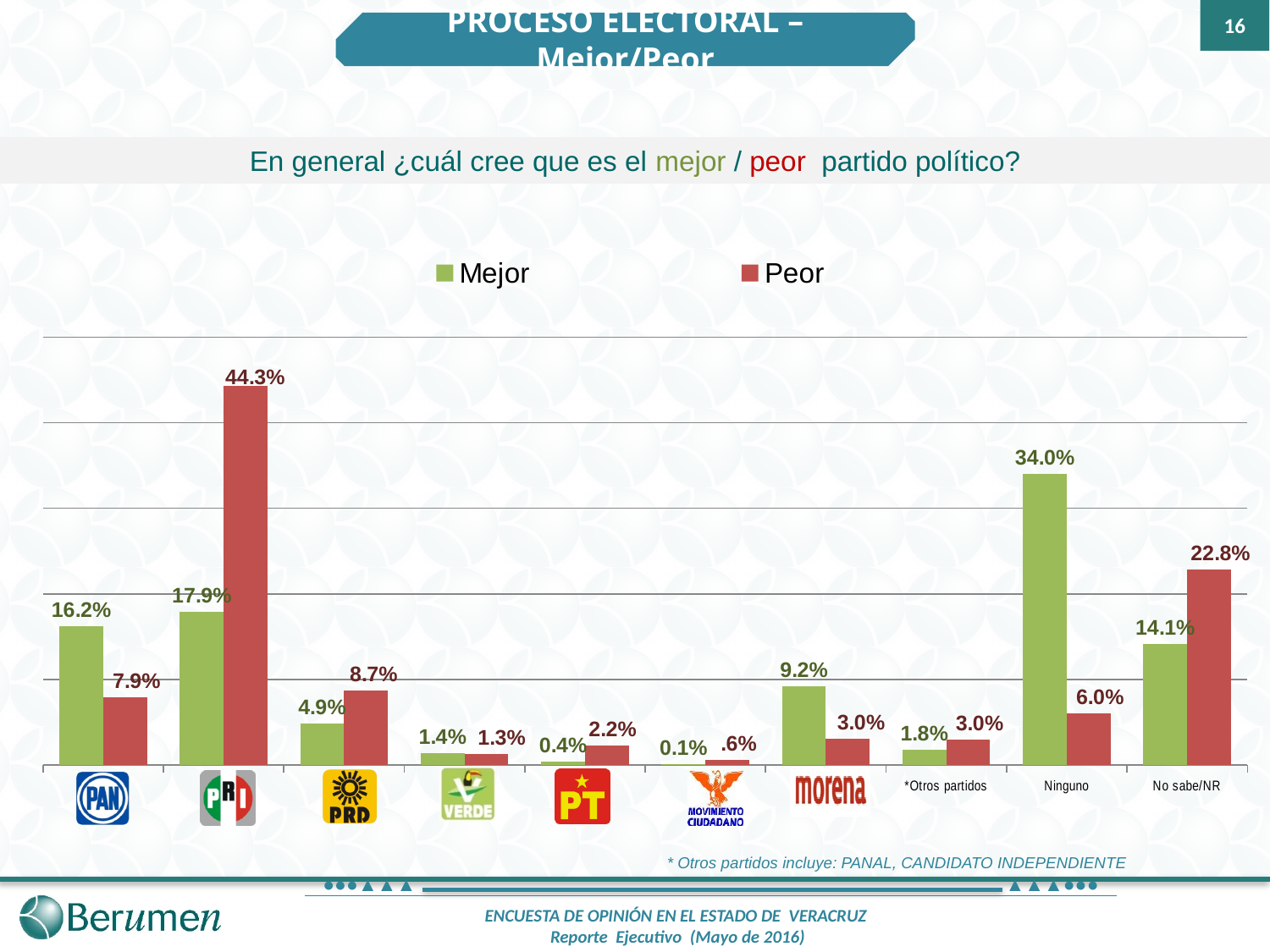
How many series does the legend list? 2 Which category has the lowest Mejor value? Movimiento Ciudadano Which category has the highest Peor value? PRI Which is larger for morena, the Mejor value or the Peor value? Mejor What is the Mejor value for Ninguno? 34.0% Which category has the highest Mejor value? Ninguno What is the Mejor value for PAN? 16.2% How many categories are shown on the x axis? 10 What kind of chart is shown on the slide? bar chart What is the Peor value for PRI? 44.3% What is the difference between the Peor and Mejor values for PRI? 26.4% What is the Peor value for No sabe/NR? 22.8%